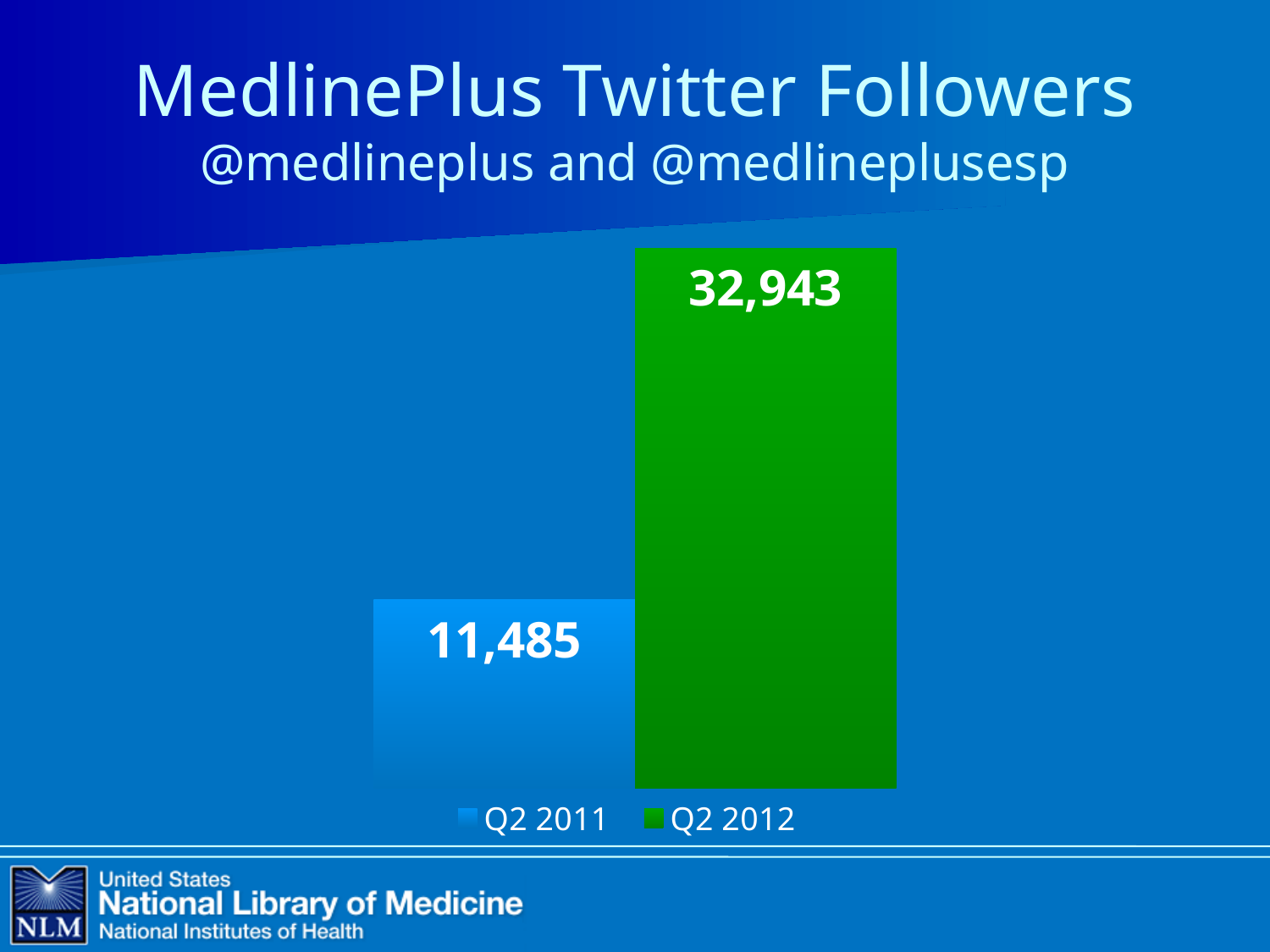
What kind of chart is shown on the slide? Bar chart Which series has the lowest value? Q2 2011 What is the title of the chart? MedlinePlus Twitter Followers What colour is the bar for Q2 2012? Green What is the difference between the Q2 2012 and Q2 2011 values? 21,458 How many series does the legend list? 2 Which series has the highest value? Q2 2012 How many bars are plotted on the chart? 2 What is the value for Q2 2011? 11,485 What is the value for Q2 2012? 32,943 Which is larger, the value for Q2 2011 or the value for Q2 2012? Q2 2012 Do the values rise or fall from Q2 2011 to Q2 2012? Rise